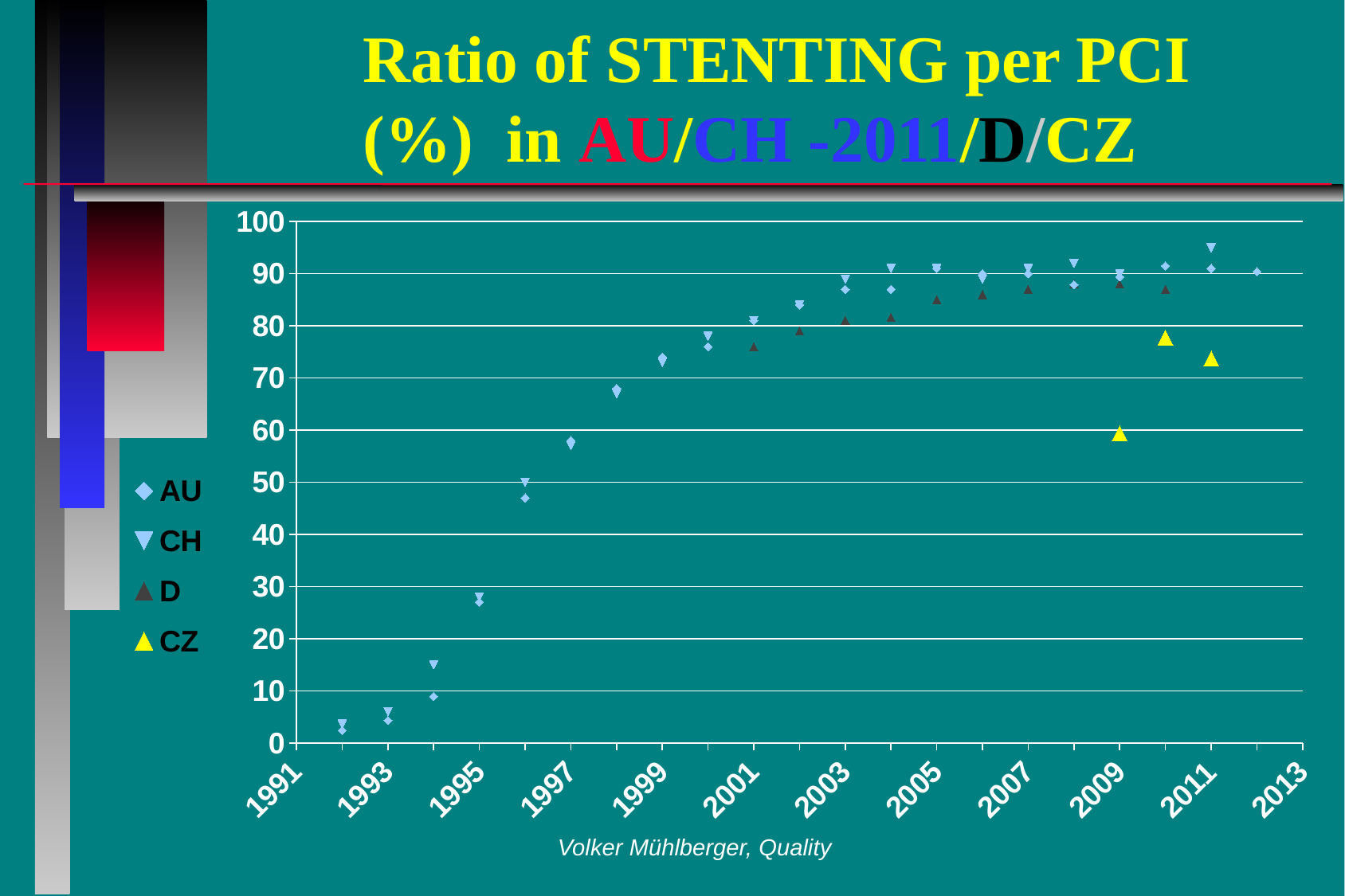
Which series has the lowest value in 2009? CZ Is the value for CZ in 2010 greater or less than 70? greater What kind of chart is shown on the slide? scatter chart How many data points are plotted for the CZ series? 3 Is the value for CH in 1994 greater or less than 10? greater Is the value for AU in 1992 greater or less than 10? less Do the AU values rise or fall from 1992 to 2011? rise In 2009, which is larger, the value for AU or the value for CZ? AU How many series does the legend list? 4 Which series has the highest value in 2011? CH